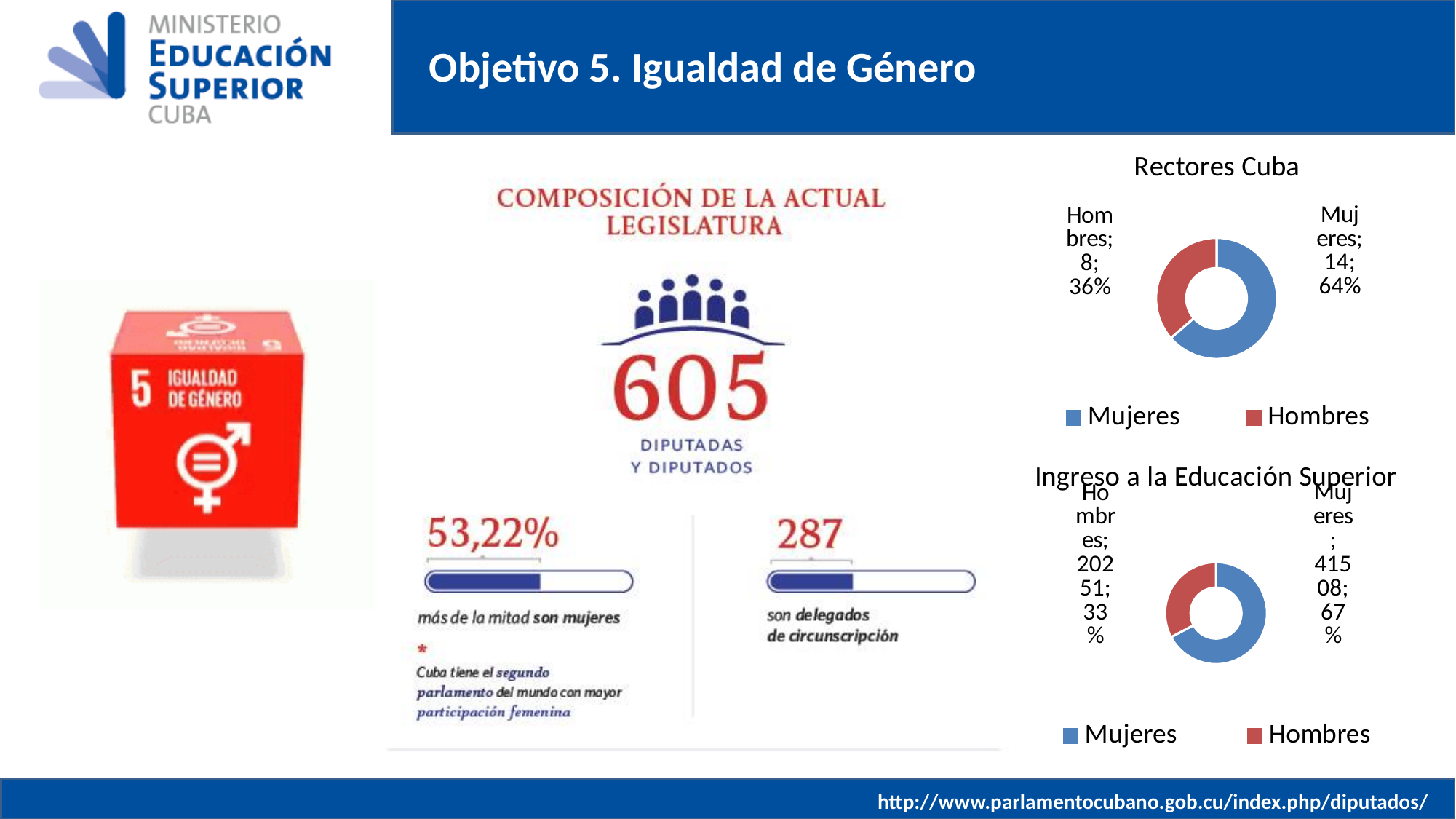
In the 'Rectores Cuba' chart, what share of the total do Mujeres represent? 64% In the 'Ingreso a la Educación Superior' chart, what share of the total do Mujeres represent? 67% In the 'Rectores Cuba' chart, which category is larger, Mujeres or Hombres? Mujeres In the 'Rectores Cuba' chart, what is the value for Mujeres? 14 How many entries does the legend of the 'Ingreso a la Educación Superior' chart list? 2 In the 'Rectores Cuba' chart, what is the difference between the Mujeres and Hombres values? 6 What kind of chart is the 'Rectores Cuba' chart? Doughnut chart In the 'Rectores Cuba' chart, what is the value for Hombres? 8 In the 'Ingreso a la Educación Superior' chart, what is the value for Mujeres? 41508 In the 'Rectores Cuba' chart, what share of the total do Hombres represent? 36% In the 'Ingreso a la Educación Superior' chart, what is the value for Hombres? 20251 In the 'Ingreso a la Educación Superior' chart, which category is the largest? Mujeres